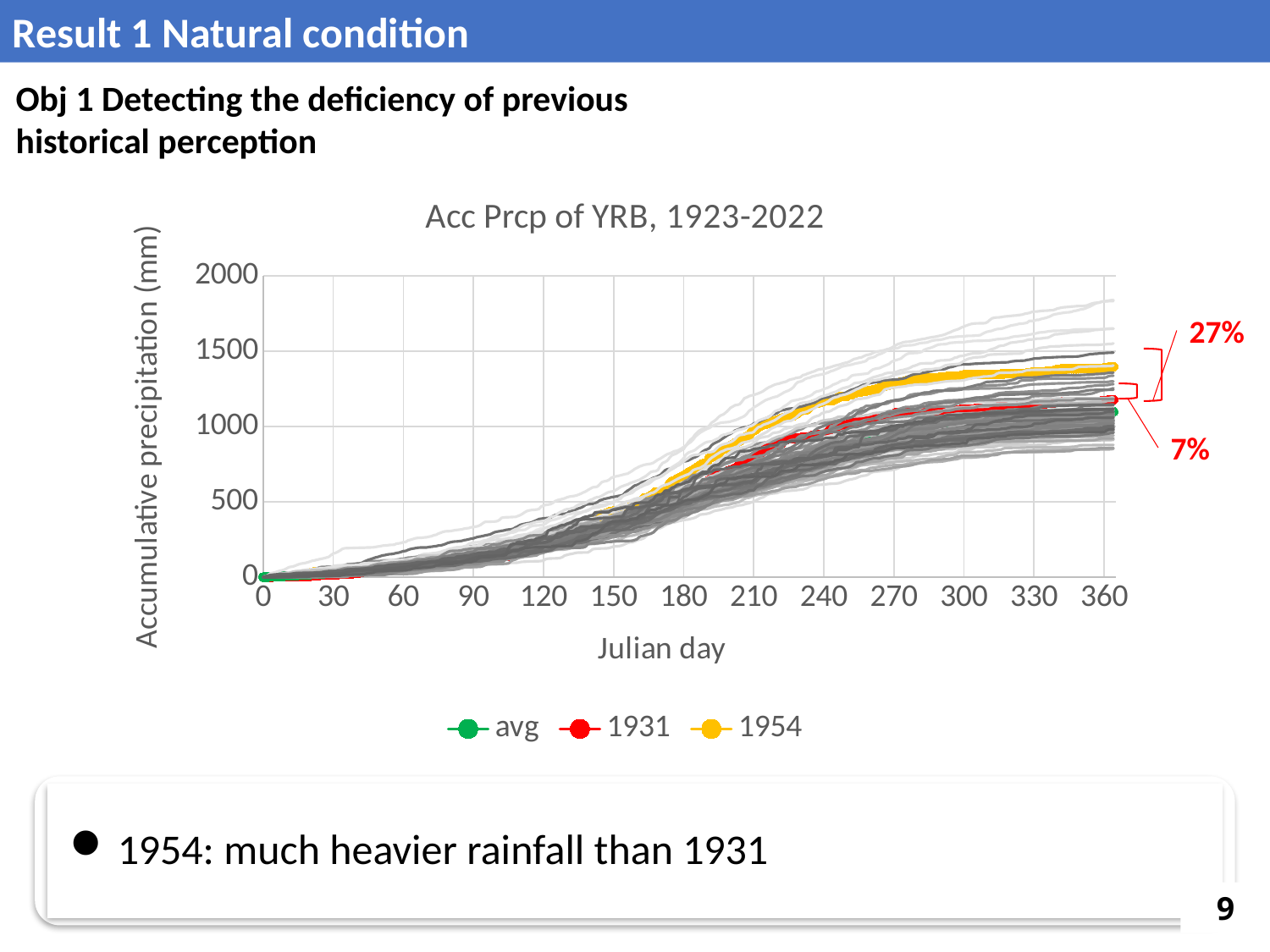
Is the value for the 1954 series at Julian day 360 greater or less than 1500? less Which of the two series, 1954 or 1931, has the larger accumulative precipitation at Julian day 360? 1954 What is the title of the chart? Acc Prcp of YRB, 1923-2022 Is the value for the avg series at Julian day 360 greater or less than 1500? less Is the value for the 1931 series at Julian day 360 greater or less than 1000? greater Do the accumulative precipitation values rise or fall as Julian day increases? rise Which of the two series, 1954 or avg, has the larger accumulative precipitation at Julian day 300? 1954 What kind of chart is shown on the slide? line chart How many series does the chart legend list? 3 Which series are listed in the chart legend? avg, 1931, 1954